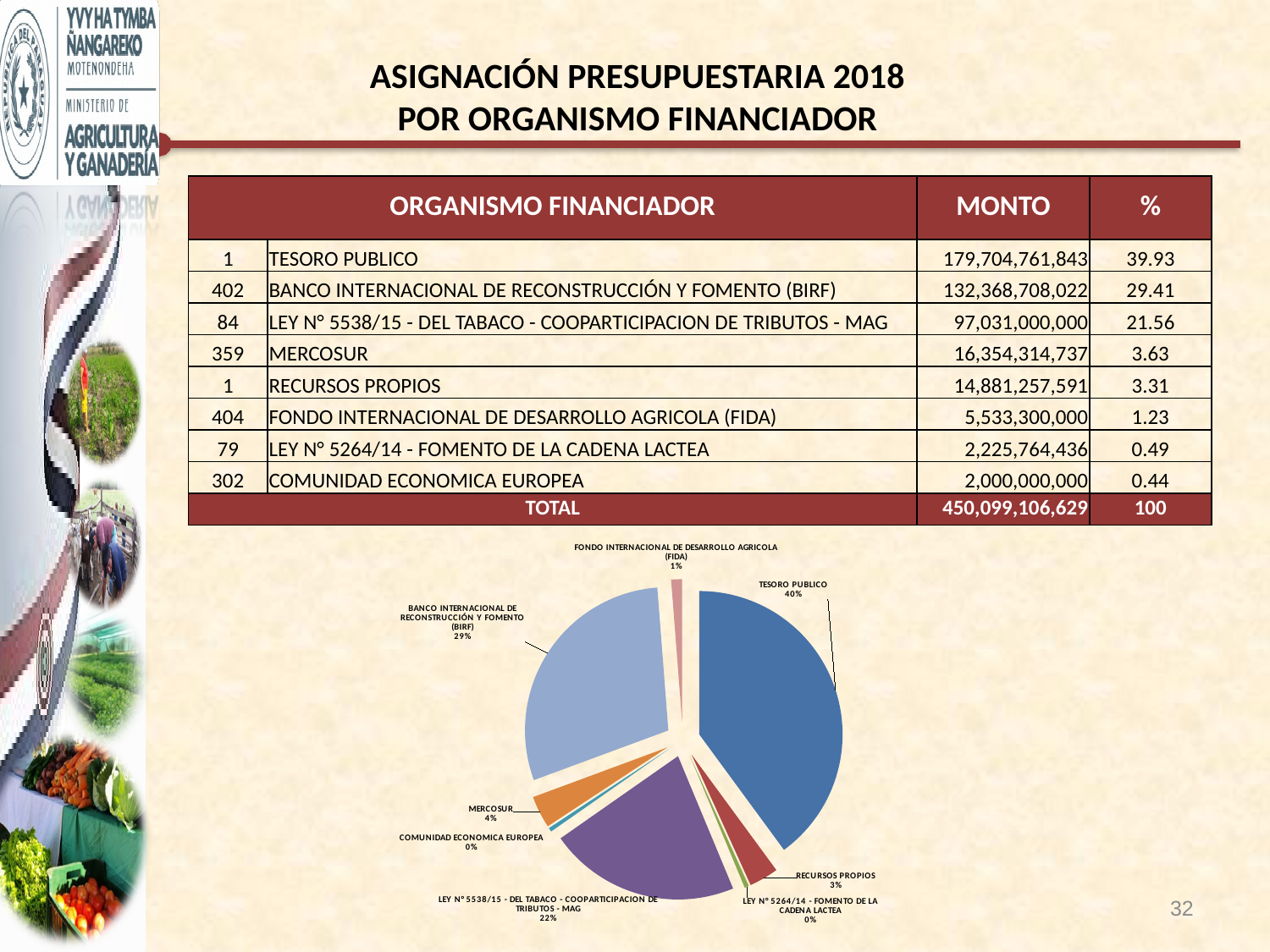
Which slice of the pie chart is the largest? TESORO PUBLICO What is the title shown above the table and chart on the slide? ASIGNACIÓN PRESUPUESTARIA 2018 POR ORGANISMO FINANCIADOR In the pie chart, what share is labelled for TESORO PUBLICO? 40% How many slices does the pie chart have? 8 In the pie chart, what share is labelled for RECURSOS PROPIOS? 3% In the pie chart, what share is labelled for FONDO INTERNACIONAL DE DESARROLLO AGRICOLA (FIDA)? 1% In the pie chart, which is larger: the share for MERCOSUR or the share for RECURSOS PROPIOS? MERCOSUR In the pie chart, what is the difference in percentage points between the TESORO PUBLICO share and the BIRF share? 11 What kind of chart is shown on the slide? pie chart